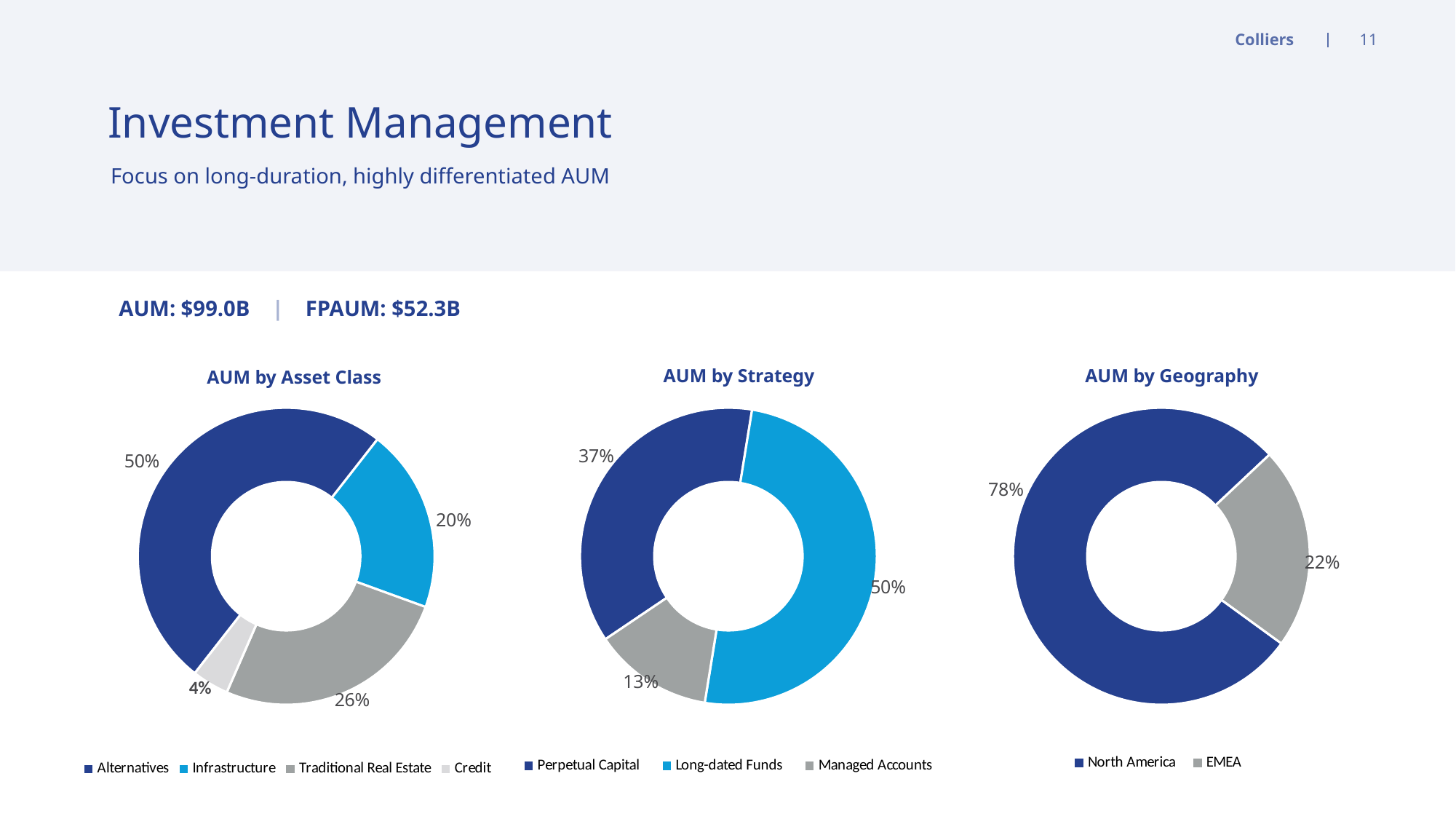
In the AUM by Asset Class chart, which category has the smallest share? Credit In the AUM by Asset Class chart, how many categories does the legend list? 4 In the AUM by Asset Class chart, what is the difference between the Infrastructure and Credit shares? 16% In the AUM by Strategy chart, what share is Managed Accounts? 13% In the AUM by Strategy chart, what share is Perpetual Capital? 37% In the AUM by Strategy chart, which category has the largest share? Long-dated Funds In the AUM by Asset Class chart, what share is Traditional Real Estate? 26% In the AUM by Asset Class chart, what share is Alternatives? 50% In the AUM by Geography chart, what is the difference between the North America and EMEA shares? 56% In the AUM by Geography chart, what share is EMEA? 22% What kind of chart is the AUM by Geography chart? Doughnut chart In the AUM by Strategy chart, which is larger, Perpetual Capital or Managed Accounts? Perpetual Capital